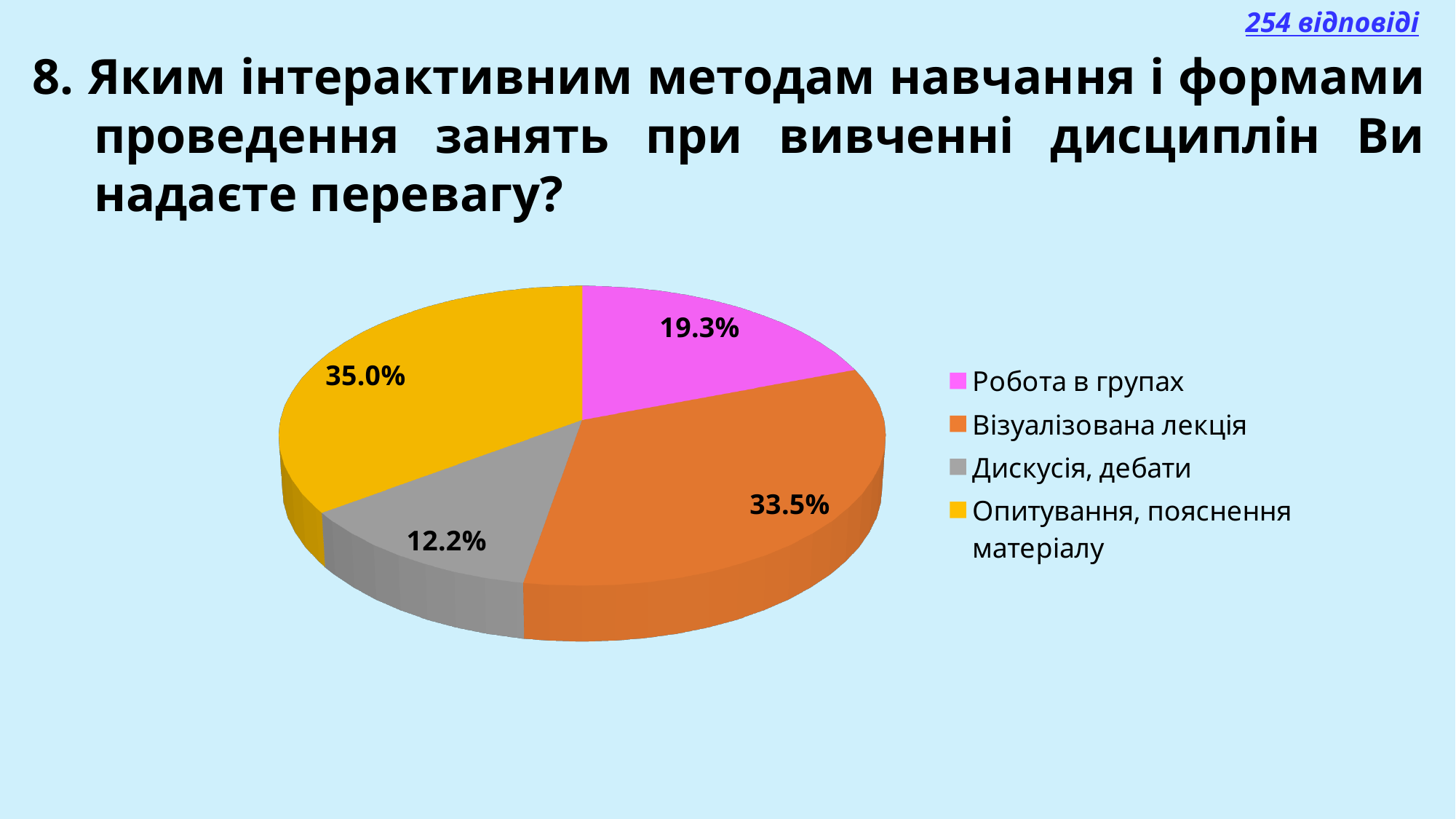
What percentage of the pie is labelled for Візуалізована лекція? 33.5% Which category has the largest slice of the pie? Опитування, пояснення матеріалу What colour is the slice for Візуалізована лекція? Orange What is the difference in percentage points between Опитування, пояснення матеріалу and Дискусія, дебати? 22.8 What percentage of the pie is labelled for Опитування, пояснення матеріалу? 35.0% Which is larger: the slice for Робота в групах or the slice for Дискусія, дебати? Робота в групах What kind of chart is shown on the slide? Pie chart Which category has the smallest slice of the pie? Дискусія, дебати How many slices does the pie chart have? 4 What percentage of the pie is labelled for Робота в групах? 19.3% How many responses does the slide say the chart is based on? 254 What percentage of the pie is labelled for Дискусія, дебати? 12.2%